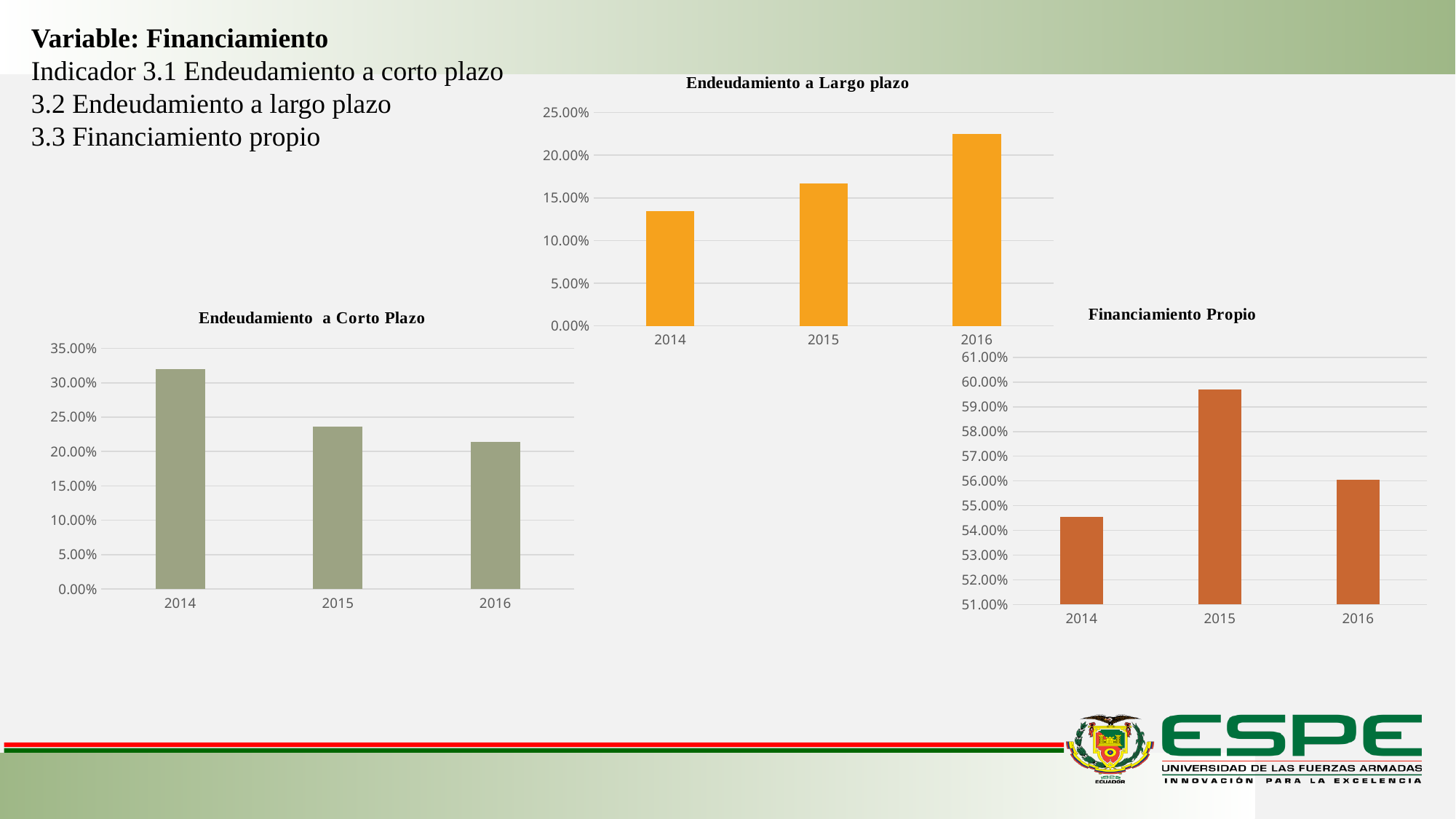
In the 'Endeudamiento a Corto Plazo' chart, do the values rise or fall from 2014 to 2016? fall In the 'Endeudamiento a Corto Plazo' chart, which year has the highest value? 2014 In the 'Financiamiento Propio' chart, which year has the lowest value? 2014 In the 'Endeudamiento a Corto Plazo' chart, is the value for 2014 greater or less than 30.00%? greater In the 'Endeudamiento a Corto Plazo' chart, which year has the lowest value? 2016 In the 'Financiamiento Propio' chart, which year has the highest value? 2015 In the 'Endeudamiento a Largo plazo' chart, which year has the highest value? 2016 In the 'Endeudamiento a Largo plazo' chart, is the value for 2016 greater or less than 20.00%? greater In the 'Financiamiento Propio' chart, which is larger, the value for 2015 or the value for 2016? 2015 In the 'Endeudamiento a Largo plazo' chart, do the values rise or fall from 2014 to 2016? rise In the 'Financiamiento Propio' chart, is the value for 2014 greater or less than 55.00%? less How many years are shown on the x axis of the 'Endeudamiento a Largo plazo' chart? 3